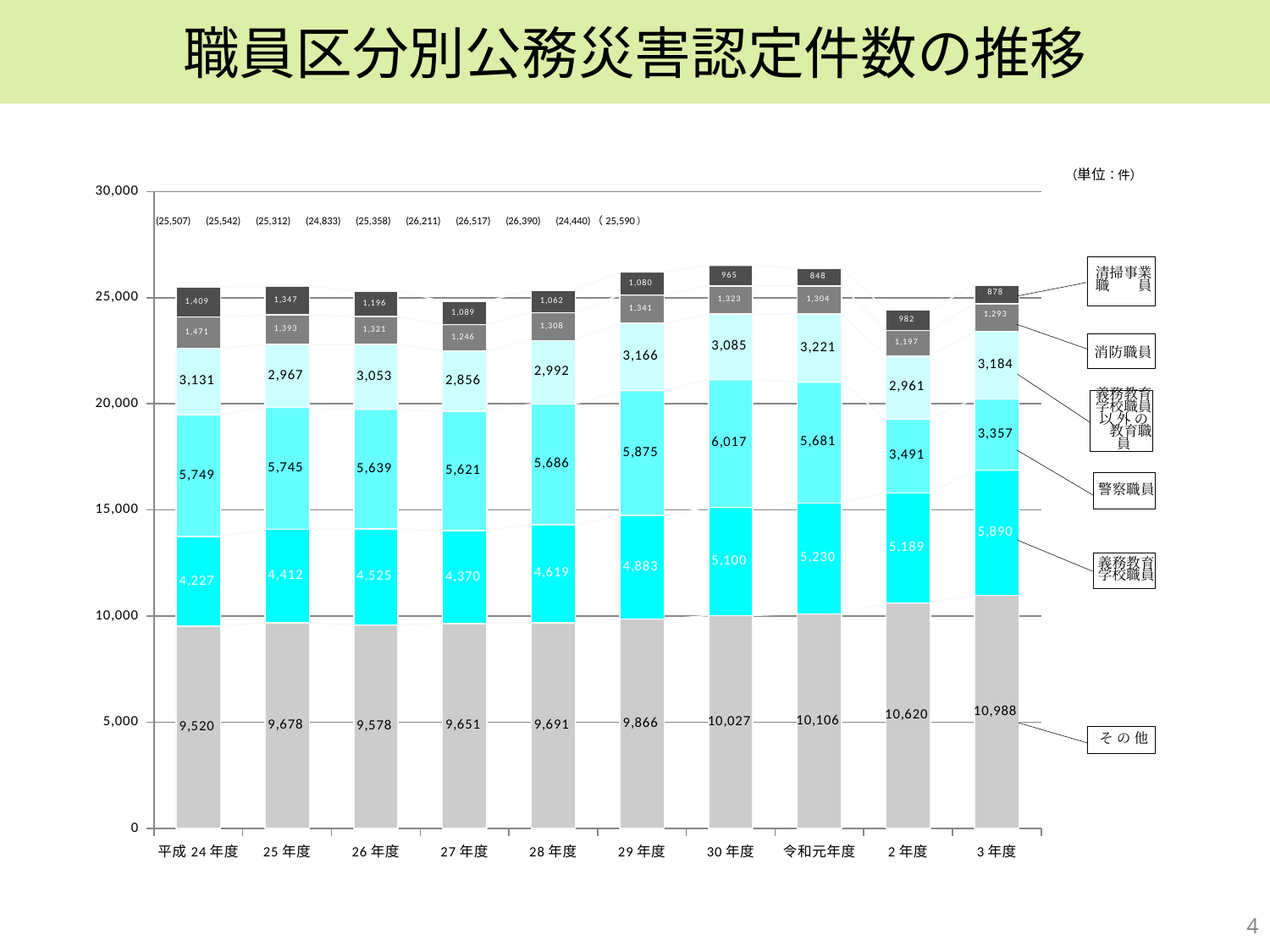
Which fiscal year has the highest value for その他? 3年度 How many staff categories (series) are stacked in each bar? 6 What is the value for 警察職員 in 30年度? 6,017 How many fiscal years (categories) are plotted on the x axis? 10 What is the value for 清掃事業職員 in 令和元年度? 848 Which fiscal year has the lowest value for 義務教育学校職員? 平成24年度 Which is larger, the 警察職員 value in 29年度 or in 2年度? 29年度 What is the total of the stacked bar for 30年度? 26,517 What type of chart is shown on the slide? stacked bar chart What is the difference between the その他 values for 3年度 and 平成24年度? 1,468 What is the value for その他 in 3年度? 10,988 Does the value for その他 rise or fall from 平成24年度 to 3年度? rise